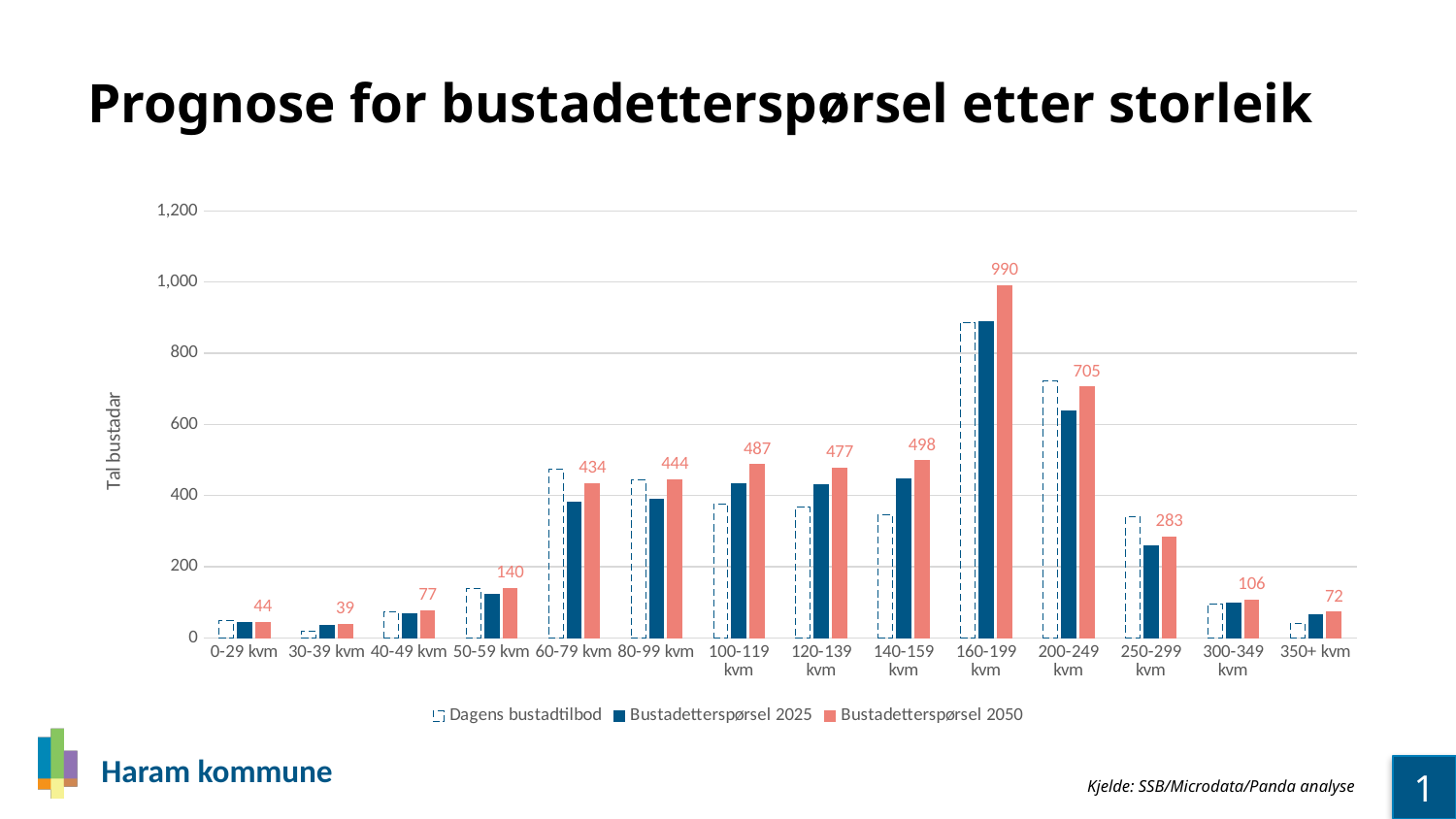
Is the Bustadetterspørsel 2025 value for 200-249 kvm greater or less than 600? greater How many series does the legend list? 3 What is the difference between the Bustadetterspørsel 2050 values for 160-199 kvm and 200-249 kvm? 285 Which category has the highest Bustadetterspørsel 2050 value? 160-199 kvm How many size categories are shown on the x axis? 14 What kind of chart is shown on the slide? Bar chart Which is larger, the Bustadetterspørsel 2050 value for 140-159 kvm or for 120-139 kvm? 140-159 kvm What is the Bustadetterspørsel 2050 value for the 160-199 kvm category? 990 What is the Bustadetterspørsel 2050 value for the 250-299 kvm category? 283 What is the Bustadetterspørsel 2050 value for the 50-59 kvm category? 140 Which category has the lowest Bustadetterspørsel 2050 value? 30-39 kvm Is the Dagens bustadtilbod value for 140-159 kvm greater or less than 400? less